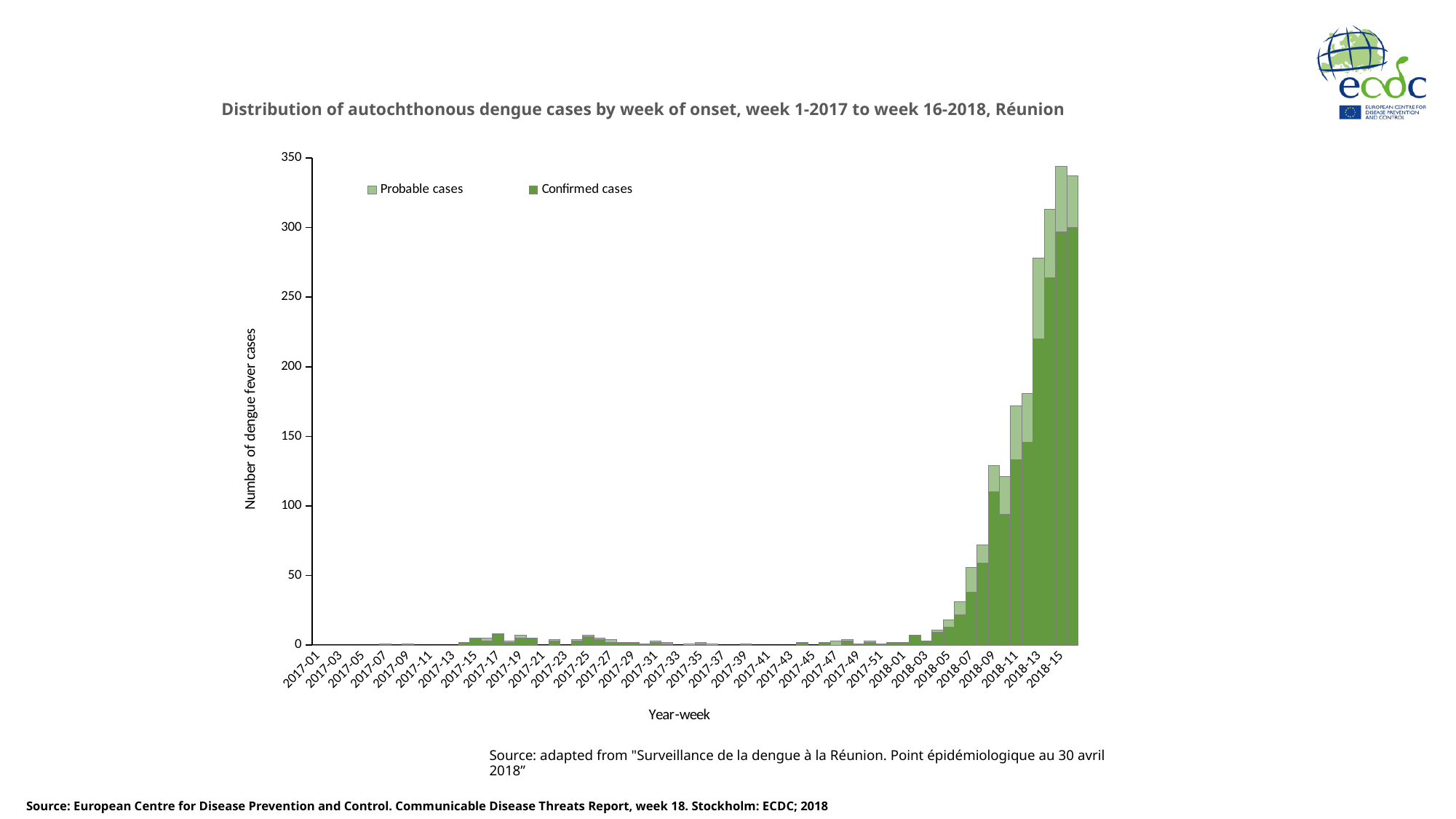
What is the label of the y axis? Number of dengue fever cases Do the weekly case totals rise or fall from week 2018-01 to week 2018-15? rise What kind of chart is shown on the slide? Stacked bar chart How many series does the legend list? 2 What are the two series named in the legend? Probable cases and Confirmed cases Is the total number of cases for week 2018-09 greater or less than 100? greater Which week has the larger total number of cases, 2018-11 or 2018-09? 2018-11 Is the total number of cases for week 2018-05 greater or less than 50? less Is the number of confirmed cases for week 2018-13 greater or less than 250? less